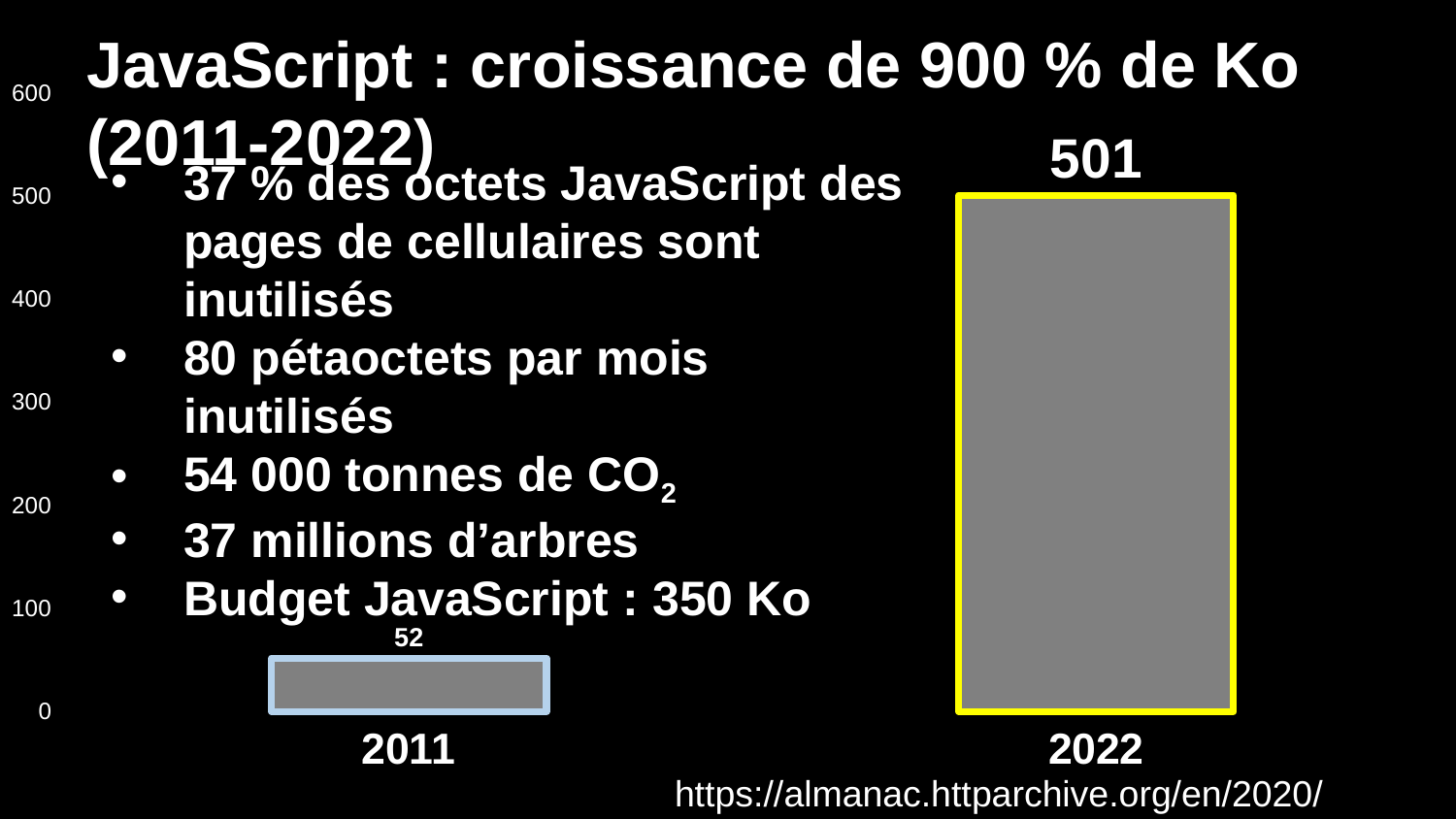
What is the value for 2011? 52 How many categories are shown on the x axis? 2 Is the value for 2022 greater or less than 400? greater What is the highest value shown on the y axis? 600 Which is larger, the value for 2011 or the value for 2022? 2022 What is the value for 2022? 501 Which year has the lowest value? 2011 Do the values rise or fall from 2011 to 2022? rise Is the value for 2011 greater or less than 100? less What kind of chart is shown on the slide? bar chart What is the difference between the values for 2022 and 2011? 449 Which year has the highest value? 2022